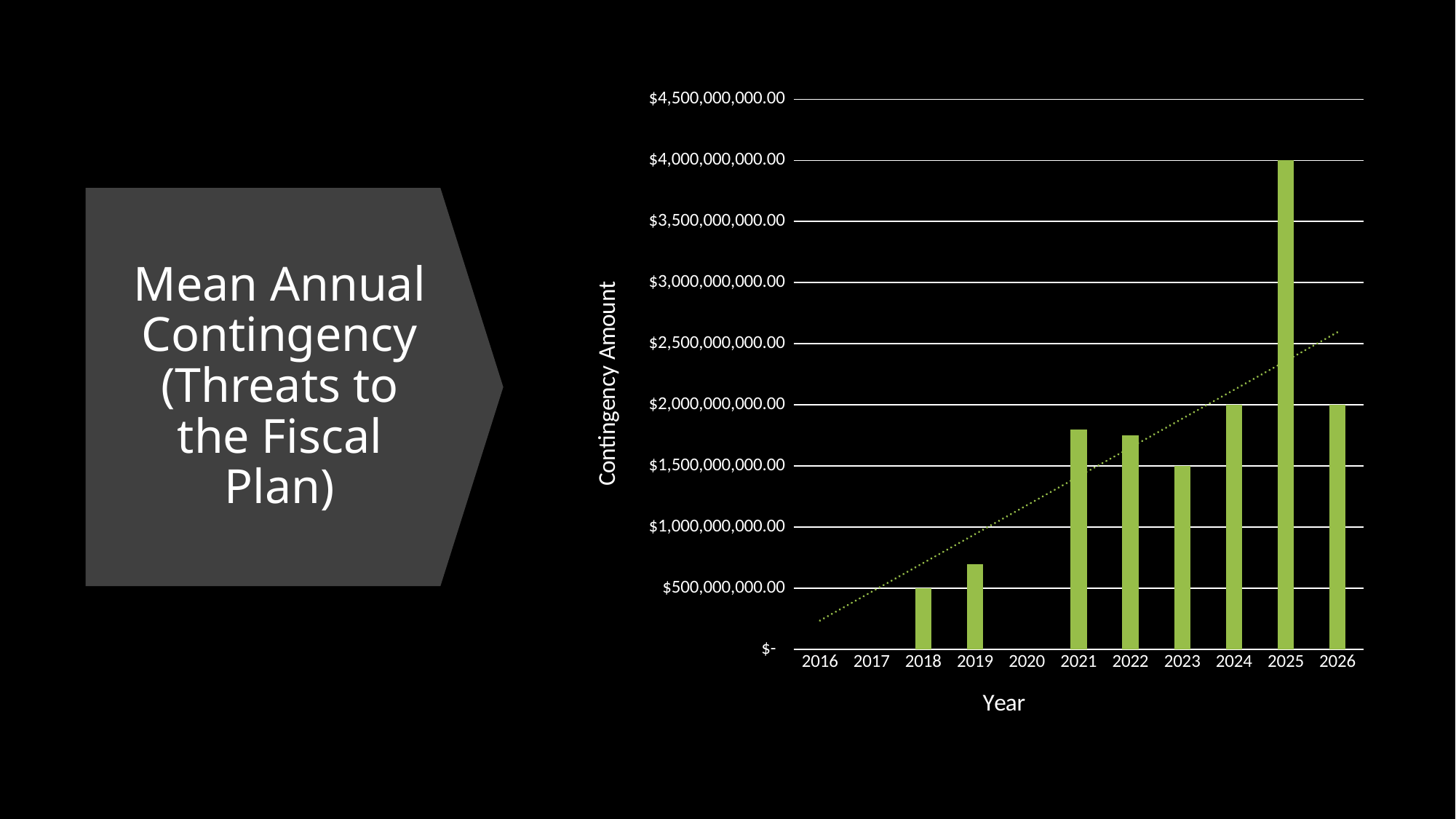
What is the difference between the contingency amounts for 2025 and 2024? $2,000,000,000.00 Which year has the larger contingency amount, 2021 or 2023? 2021 How many years are labelled on the x axis? 11 What is the contingency amount for 2025? $4,000,000,000.00 What is the contingency amount for 2024? $2,000,000,000.00 Which year has the highest contingency amount? 2025 Is the value for 2019 greater or less than $1,000,000,000.00? less What is the contingency amount for 2018? $500,000,000.00 What is the title of the vertical axis? Contingency Amount What type of chart is shown on the slide? bar chart Which year has the shortest bar shown on the chart? 2018 Is the value for 2021 greater or less than $1,500,000,000.00? greater